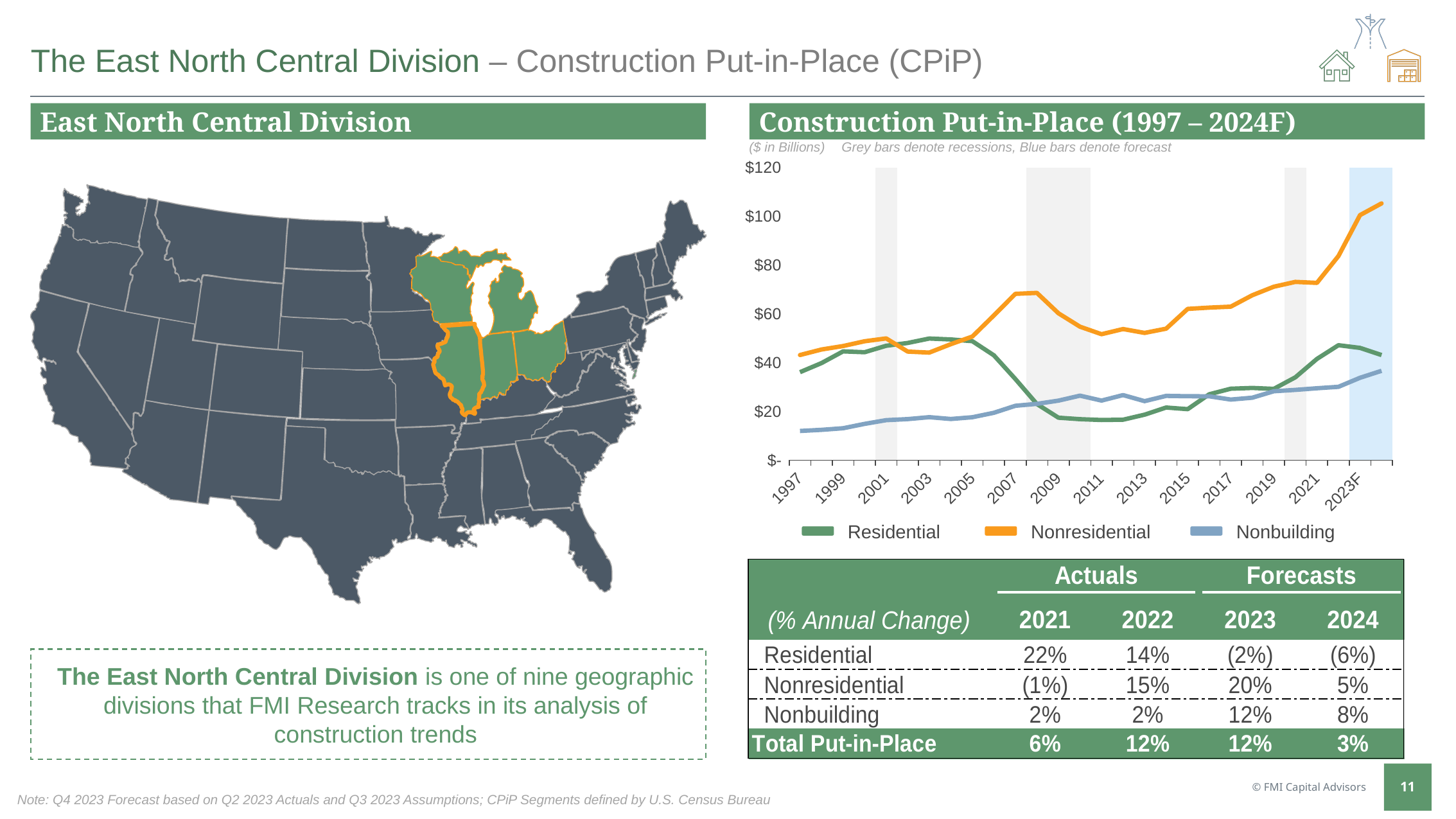
Is the Nonresidential value in 2023F greater or less than $80 on the Construction Put-in-Place chart? greater What kind of chart is the Construction Put-in-Place (1997 – 2024F) chart? line chart In 2013, which is larger on the Construction Put-in-Place chart: Residential or Nonbuilding? Nonbuilding Is the Nonbuilding value in 1997 greater or less than $20 on the Construction Put-in-Place chart? less Is the Residential value in 2009 greater or less than $20 on the Construction Put-in-Place chart? less Which series is shown in orange on the Construction Put-in-Place chart? Nonresidential Which series has the lowest value in 1997 on the Construction Put-in-Place chart? Nonbuilding How many series does the legend of the Construction Put-in-Place chart list? 3 According to the note on the Construction Put-in-Place chart, what do the grey bars denote? recessions Which series has the highest value in 2023F on the Construction Put-in-Place chart? Nonresidential Does the Residential series rise or fall between 2005 and 2009 on the Construction Put-in-Place chart? fall